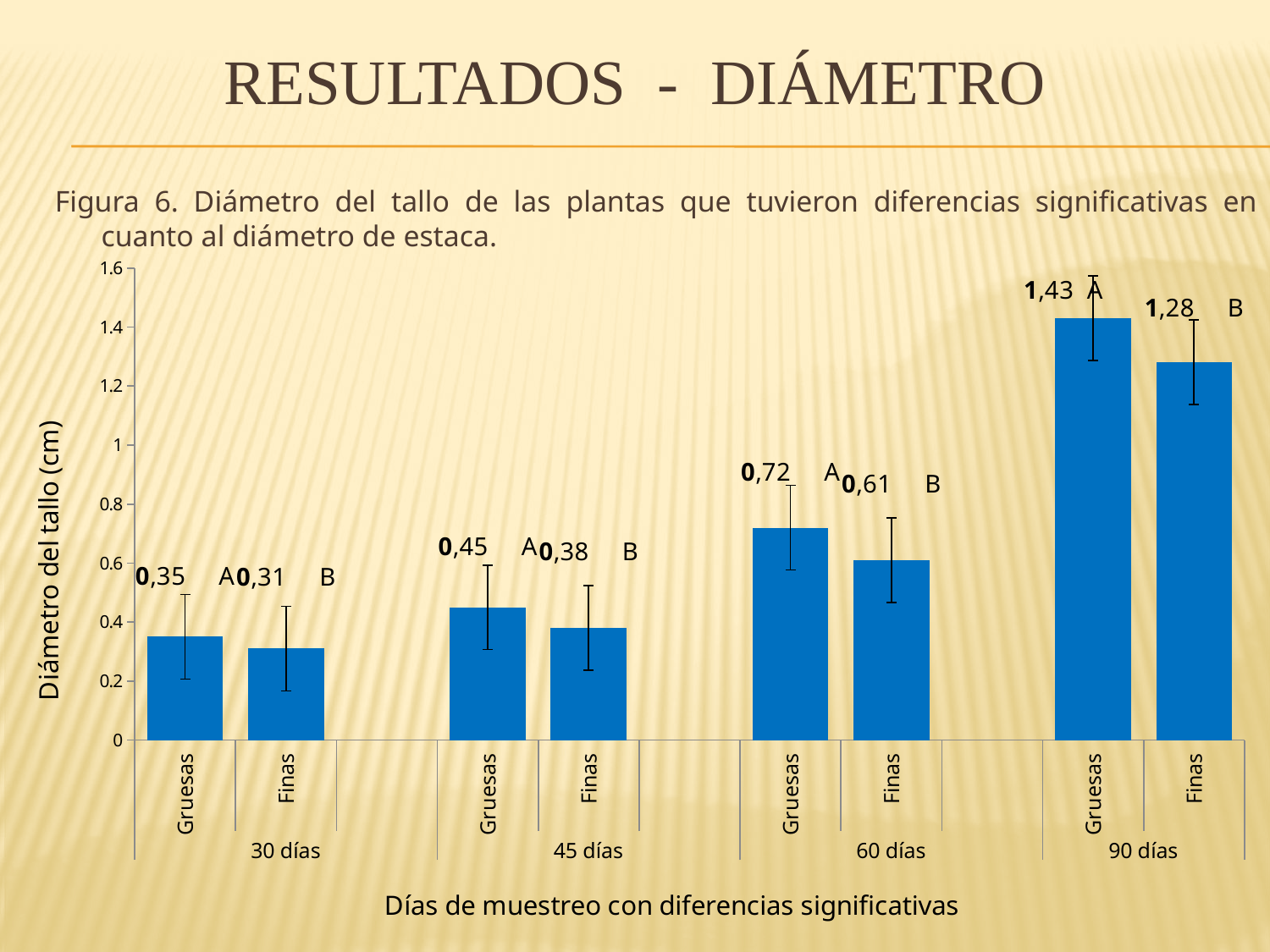
What is the difference between the Gruesas and Finas values at 60 días? 0,11 What is the stem diameter for Finas at 45 días? 0,38 How many bars are plotted in the chart? 8 What is the stem diameter for Gruesas at 60 días? 0,72 What is the stem diameter for Gruesas at 30 días? 0,35 What type of chart is shown on the slide? bar chart What is the difference between the Gruesas and Finas values at 90 días? 0,15 What is the stem diameter for Finas at 90 días? 1,28 What is the label of the y axis? Diámetro del tallo (cm) Which bar has the lowest value in the chart? Finas at 30 días Which is larger, the Gruesas value at 45 días or the Finas value at 60 días? Finas at 60 días Which bar has the highest value in the chart? Gruesas at 90 días